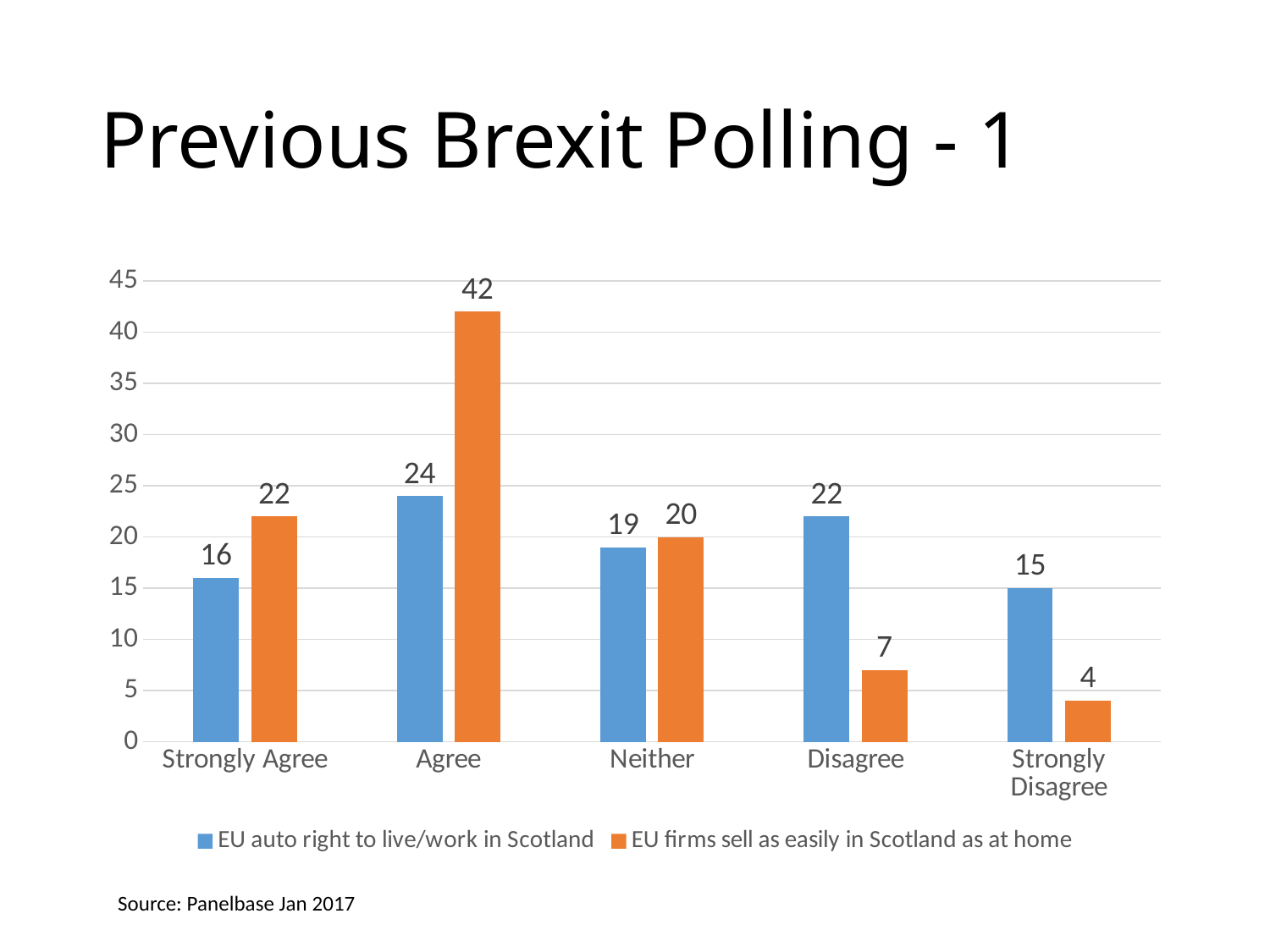
How many categories are shown on the x axis? 5 Is the value for 'Agree' in the 'EU auto right to live/work in Scotland' series greater or less than 20? greater What source is cited below the chart? Panelbase Jan 2017 What is the value for 'Agree' in the 'EU firms sell as easily in Scotland as at home' series? 42 What is the value for 'Neither' in the 'EU firms sell as easily in Scotland as at home' series? 20 Which category has the highest value in the 'EU firms sell as easily in Scotland as at home' series? Agree Which category has the lowest value in the 'EU auto right to live/work in Scotland' series? Strongly Disagree What kind of chart is shown on the slide? Bar chart How many series does the legend list? 2 What is the value for 'Strongly Disagree' in the 'EU auto right to live/work in Scotland' series? 15 For 'Strongly Agree', which series has the larger value? EU firms sell as easily in Scotland as at home What is the difference between the two series' values for 'Disagree'? 15